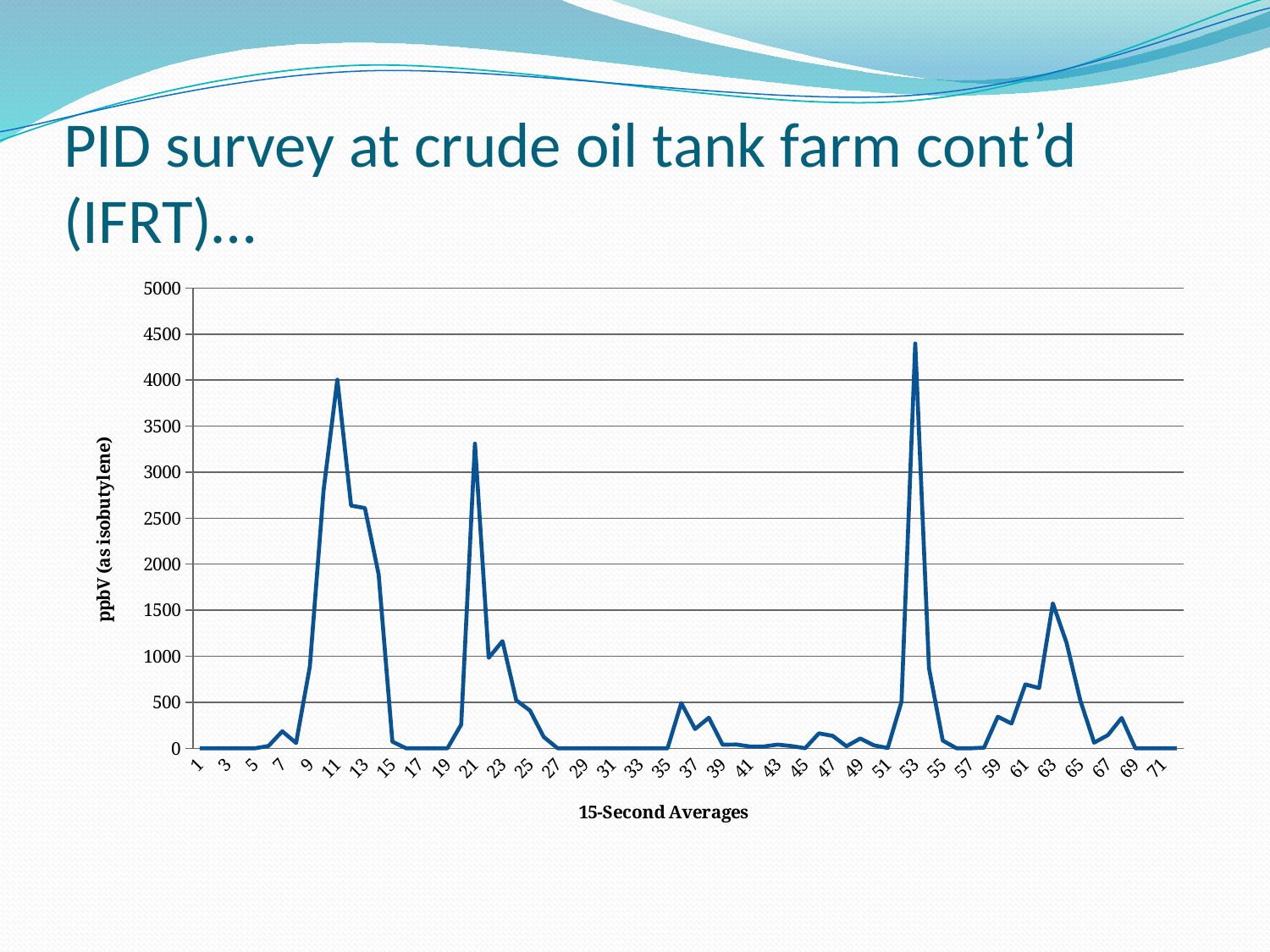
What is the title of the vertical axis? ppbV (as isobutylene) Is the value at point 11 greater or less than 3500? greater At which 15-second average point does the line reach its highest value? 53 Is the value at point 63 greater or less than 1000? greater Is the value at point 53 greater or less than 4000? greater Which is larger, the value at point 53 or the value at point 63? point 53 What is the title of the horizontal axis? 15-Second Averages Which is larger, the value at point 11 or the value at point 21? point 11 What kind of chart is shown on the slide? line chart